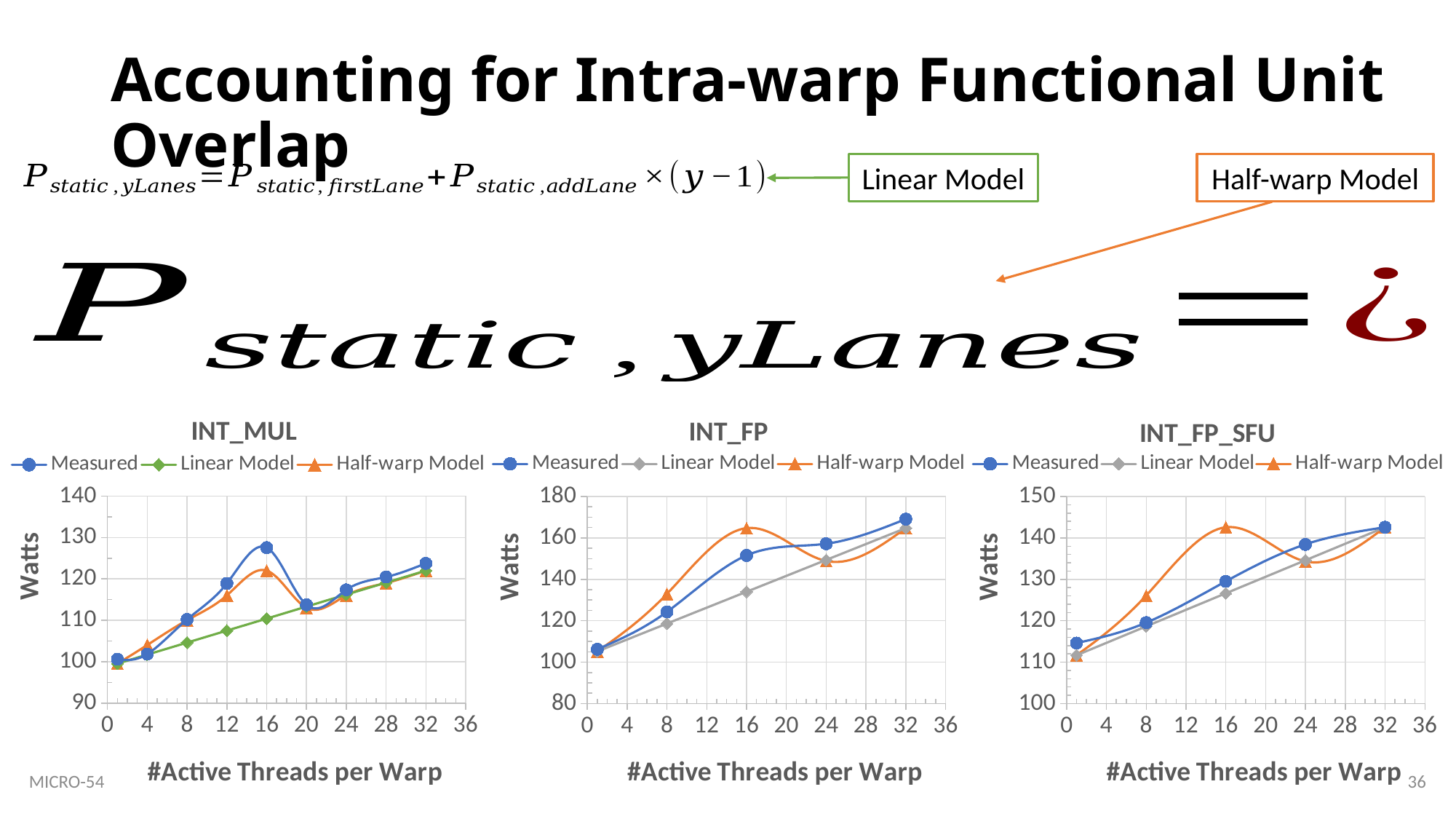
What is the y-axis label of the INT_FP chart? Watts In the INT_MUL chart, is the Linear Model value at 16 active threads per warp greater or less than 120? less What kind of chart is the INT_MUL chart? line chart In the INT_FP_SFU chart, is the Half-warp Model value at 16 active threads per warp greater or less than 140? greater In the INT_FP chart, is the Linear Model value at 16 active threads per warp greater or less than 140? less In the INT_MUL chart, at which number of active threads per warp does the Measured series reach its highest value? 16 In the INT_FP chart, at which number of active threads per warp does the Measured series reach its highest value? 32 How many series does the legend of the INT_FP chart list? 3 In the INT_FP_SFU chart, does the Linear Model series rise or fall as the number of active threads per warp increases? rise